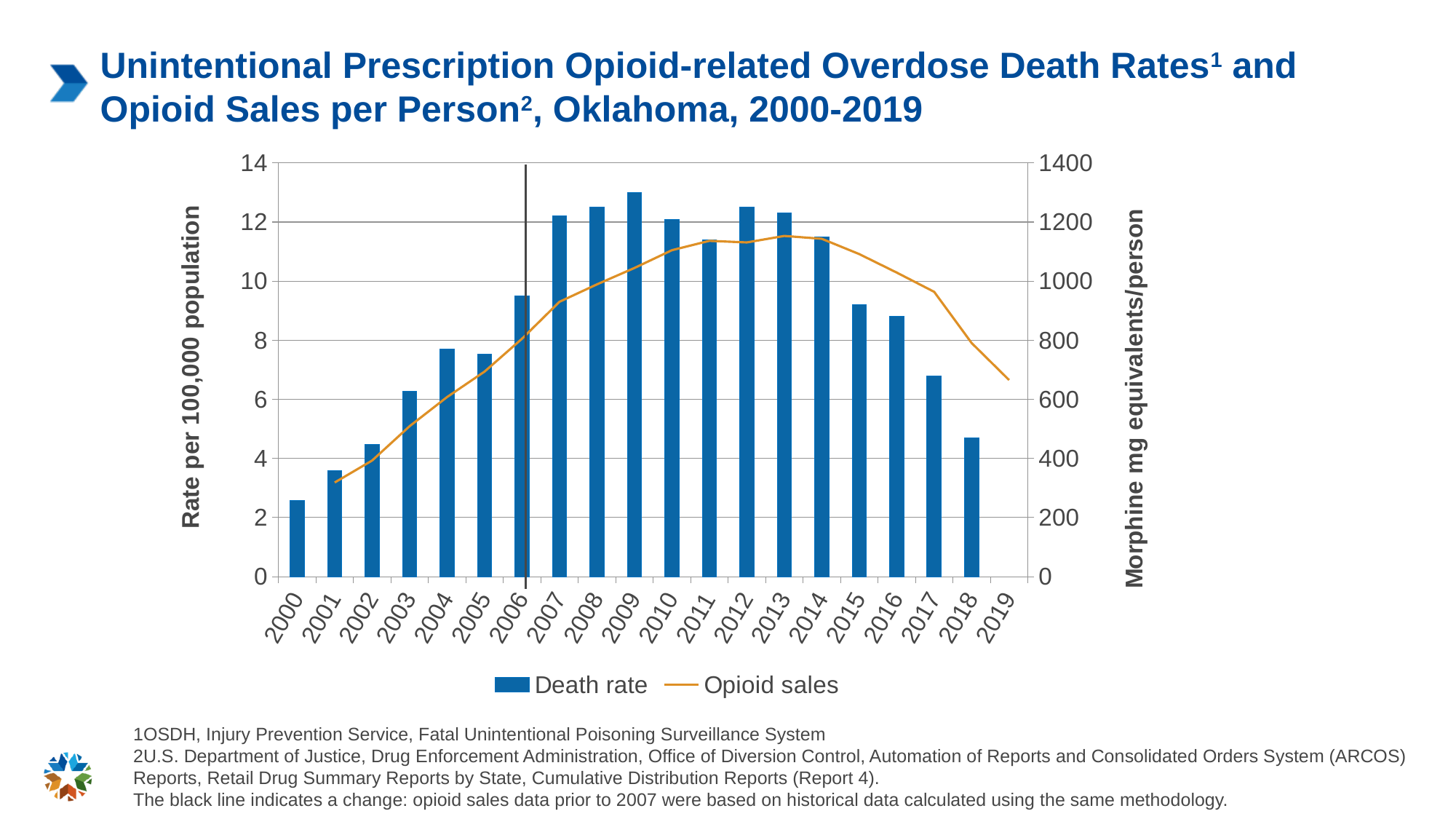
Which year has the lowest death rate bar? 2000 Is the opioid sales value for 2019 greater or less than 800? less Which series is drawn as an orange line? Opioid sales Is the death rate for 2009 greater or less than 12? greater Is the death rate for 2018 greater or less than 6? less What kind of chart is shown on the slide? A combined bar and line chart Which year has the larger death rate, 2007 or 2017? 2007 How many series does the legend list? 2 Which year has the highest death rate bar? 2009 How many years are labelled on the x axis? 20 Does the death rate rise or fall from 2014 to 2018? fall